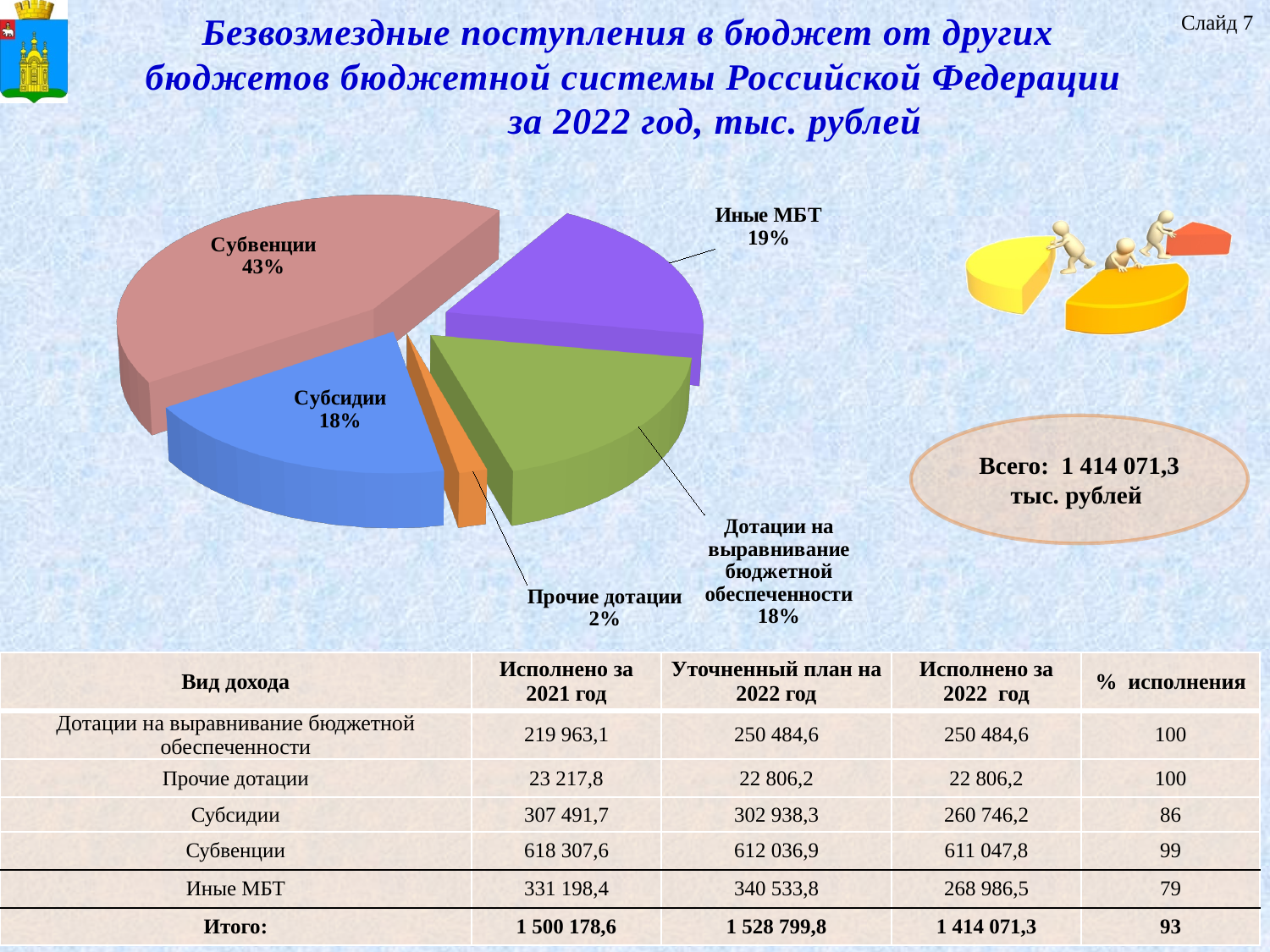
What share of the pie does Субсидии account for? 18% What share of the pie does Иные МБТ account for? 19% Which is larger in the pie chart, Иные МБТ or Субсидии? Иные МБТ What kind of chart is shown on the slide? pie chart What share of the pie does Субвенции account for? 43% How many slices does the pie chart have? 5 What total amount in thousand rubles is stated next to the pie chart? 1 414 071,3 What is the difference in percentage points between the Субвенции slice and the Иные МБТ slice? 24 Which slice of the pie chart is the smallest? Прочие дотации Which slice of the pie chart is the largest? Субвенции